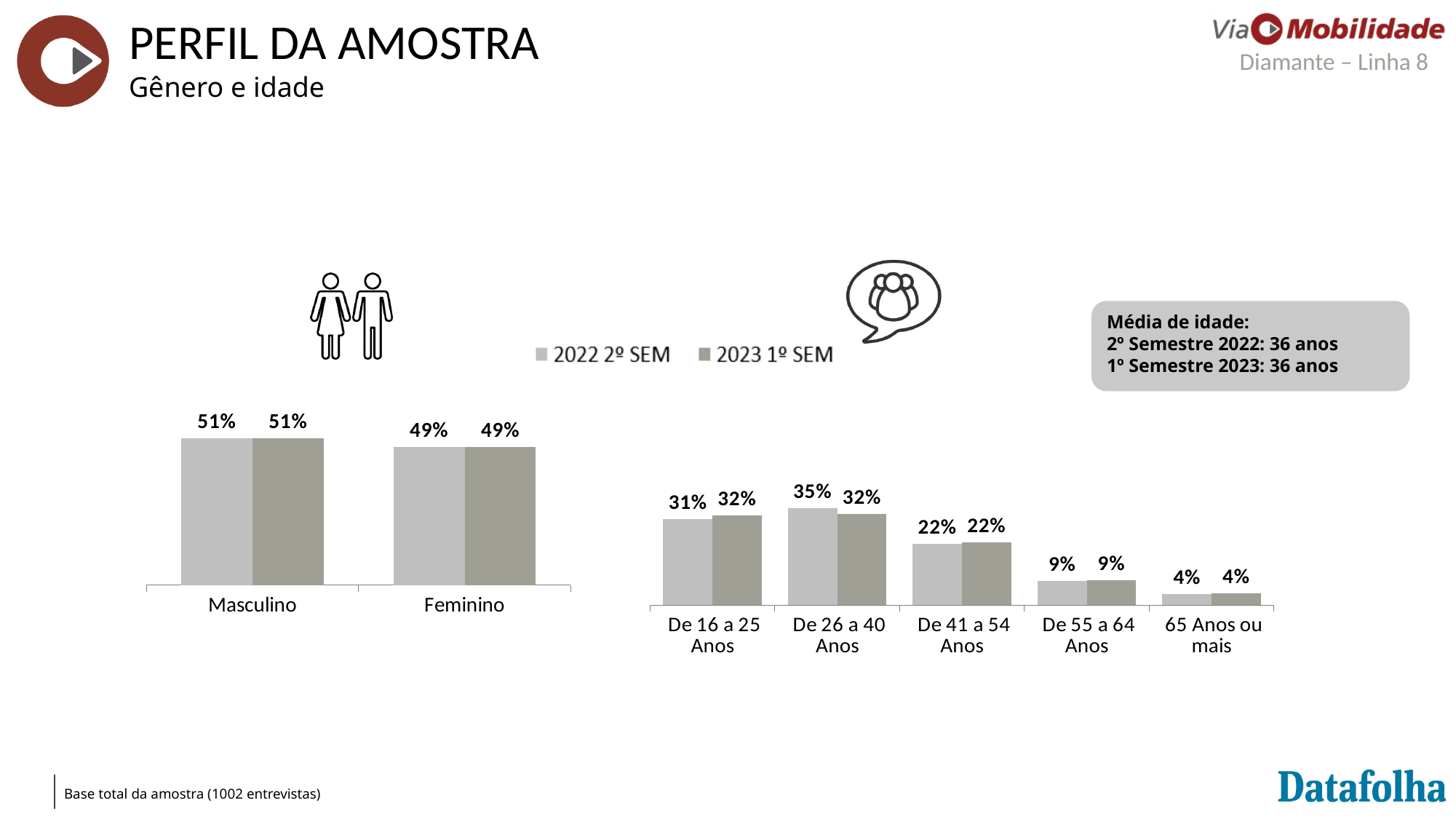
In the gender chart on the left, what is the value for Masculino in 2023 1º SEM? 51% In the gender chart on the left, what is the value for Feminino in 2022 2º SEM? 49% In the age chart on the right, what is the value for De 16 a 25 Anos in 2023 1º SEM? 32% In the age chart on the right, which age group has the highest value in 2022 2º SEM? De 26 a 40 Anos How many age groups are shown in the age chart on the right? 5 In the age chart on the right, which age group has the lowest value in 2023 1º SEM? 65 Anos ou mais In the gender chart on the left, what is the difference between Masculino and Feminino in 2023 1º SEM? 2% How many series does the legend list? 2 In the age chart on the right, what is the value for De 26 a 40 Anos in 2022 2º SEM? 35% What type of chart is the age chart on the right? Bar chart In the gender chart on the left, which category has the higher value in 2022 2º SEM, Masculino or Feminino? Masculino In the age chart on the right, what is the difference between De 26 a 40 Anos and De 41 a 54 Anos in 2023 1º SEM? 10%